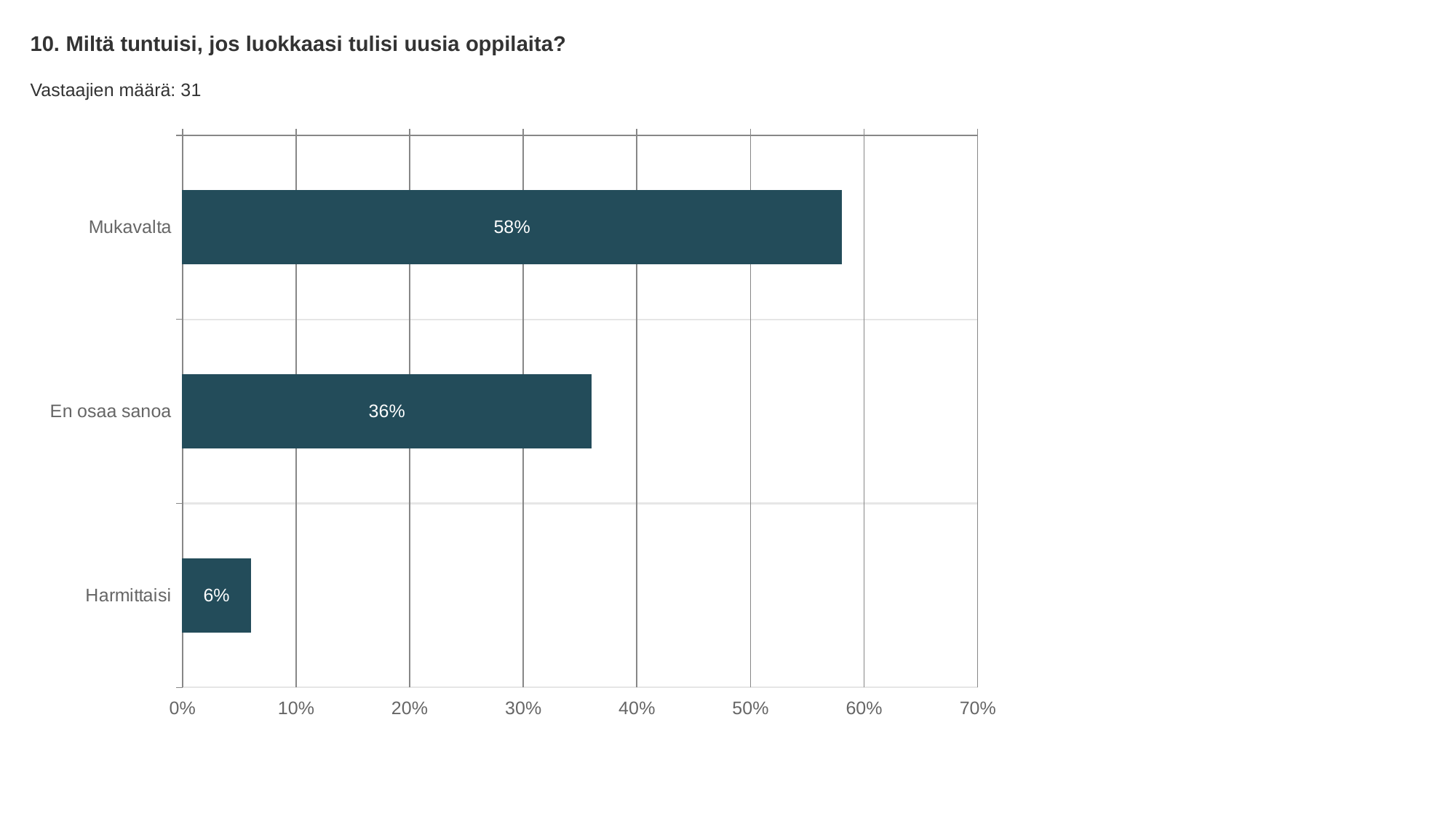
What kind of chart is shown on the slide? bar chart What is the difference between the values for En osaa sanoa and Harmittaisi? 30% What is the difference between the values for Mukavalta and En osaa sanoa? 22% Is the value for Mukavalta greater or less than 50%? greater Which category has the highest value? Mukavalta What is the value for Mukavalta? 58% What is the value for En osaa sanoa? 36% Which is larger, the value for En osaa sanoa or the value for Harmittaisi? En osaa sanoa Which category has the lowest value? Harmittaisi How many respondents (Vastaajien määrä) are reported on the slide? 31 How many categories are shown in the chart? 3 What is the value for Harmittaisi? 6%